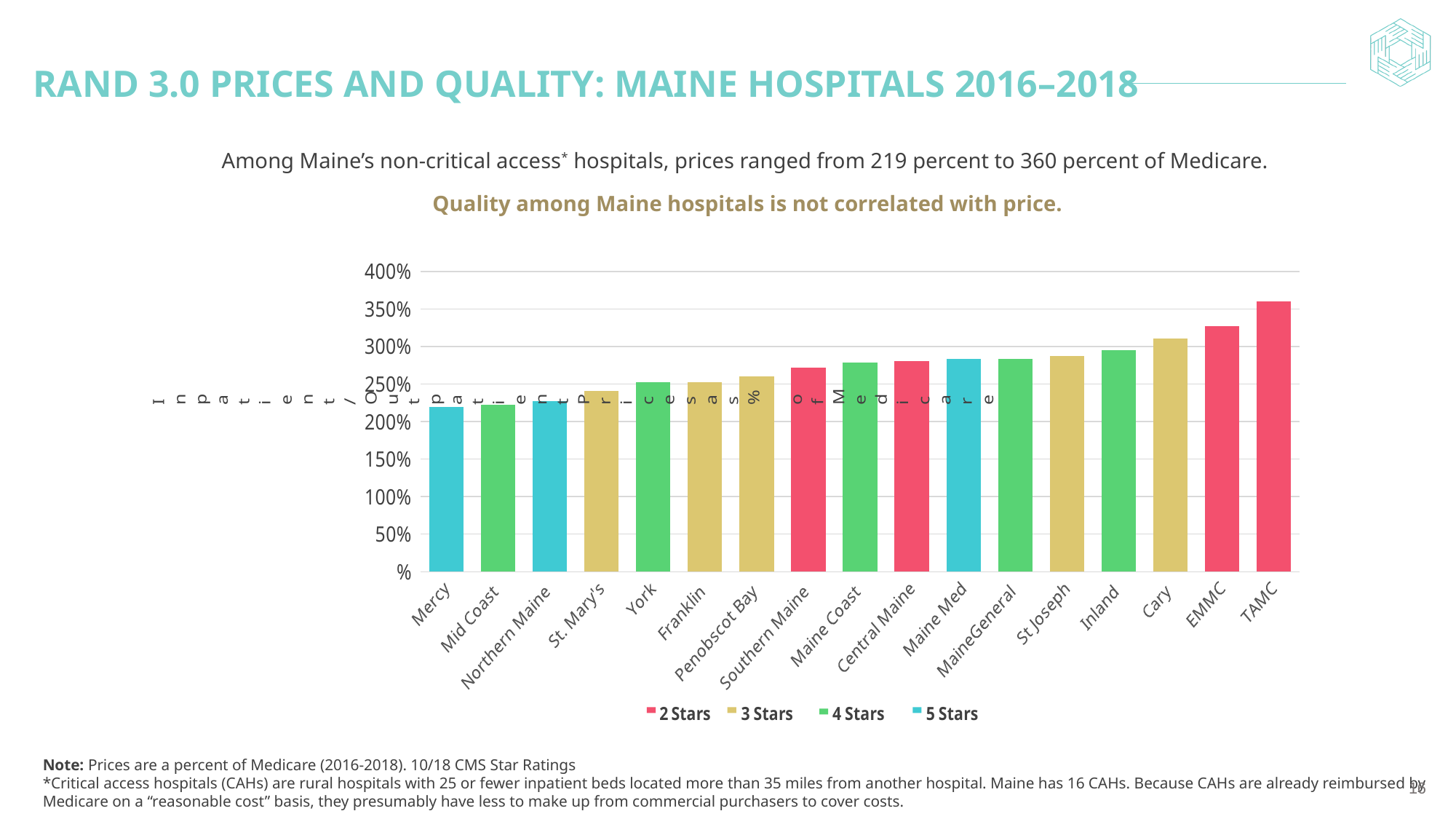
Is the value for Maine Med greater or less than 300%? less How many series does the legend list? 4 Which hospital has the lowest price as a percent of Medicare? Mercy Is the value for Mercy greater or less than 250%? less Is the value for TAMC greater or less than 350%? greater Do the bar values rise or fall moving from left to right along the x axis? rise What kind of chart is shown on the slide? bar chart How many hospitals are shown on the x axis of the chart? 17 According to the legend, which star rating does the bar for TAMC represent? 2 Stars Which hospital has the highest price as a percent of Medicare? TAMC Which has a higher value, EMMC or Cary? EMMC